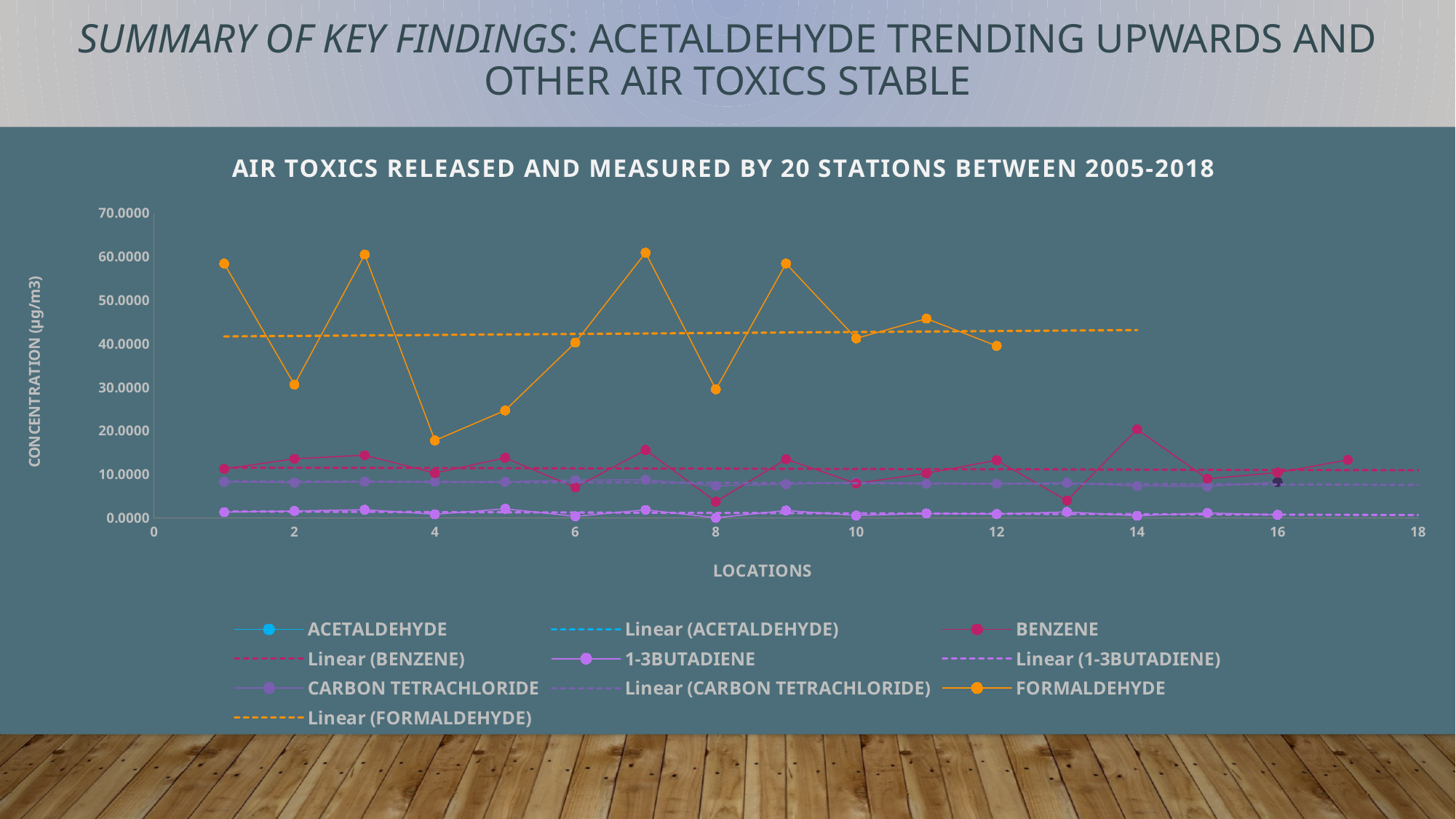
Is the FORMALDEHYDE value at location 5 greater or less than 20? greater What kind of chart is shown on the slide? Line chart How many entries does the chart legend list? 10 Is the BENZENE value at location 14 greater or less than 10? greater Is the BENZENE value at location 13 greater or less than 10? less What is the title of the chart? AIR TOXICS RELEASED AND MEASURED BY 20 STATIONS BETWEEN 2005-2018 Which series has the highest concentration values across the chart? FORMALDEHYDE Which is larger, the FORMALDEHYDE value at location 1 or at location 2? Location 1 What is the label of the y axis? CONCENTRATION (µg/m3) How many data points are plotted for the FORMALDEHYDE series? 12 At which location does FORMALDEHYDE have its lowest value? 4